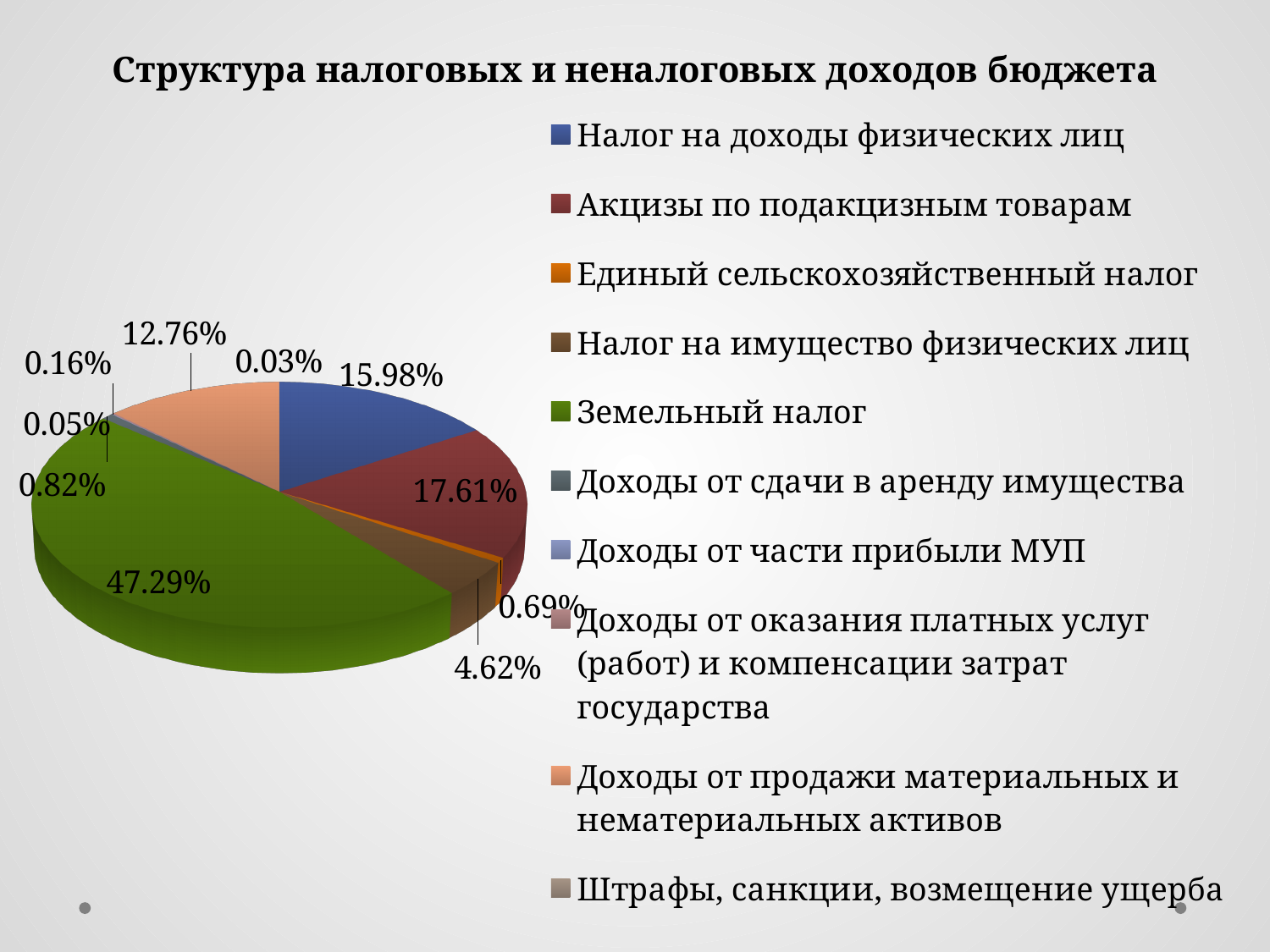
What share of the pie is Доходы от продажи материальных и нематериальных активов? 12.76% How many entries does the chart legend list? 10 What colour is the slice for Земельный налог? green What share of the pie is Налог на доходы физических лиц? 15.98% What is the difference between the shares of Земельный налог and Акцизы по подакцизным товарам? 29.68% Which is larger: Акцизы по подакцизным товарам or Налог на доходы физических лиц? Акцизы по подакцизным товарам What kind of chart is shown on the slide? pie chart What share of the pie is Налог на имущество физических лиц? 4.62% Which category has the largest share of the pie? Земельный налог What is the title of the chart? Структура налоговых и неналоговых доходов бюджета